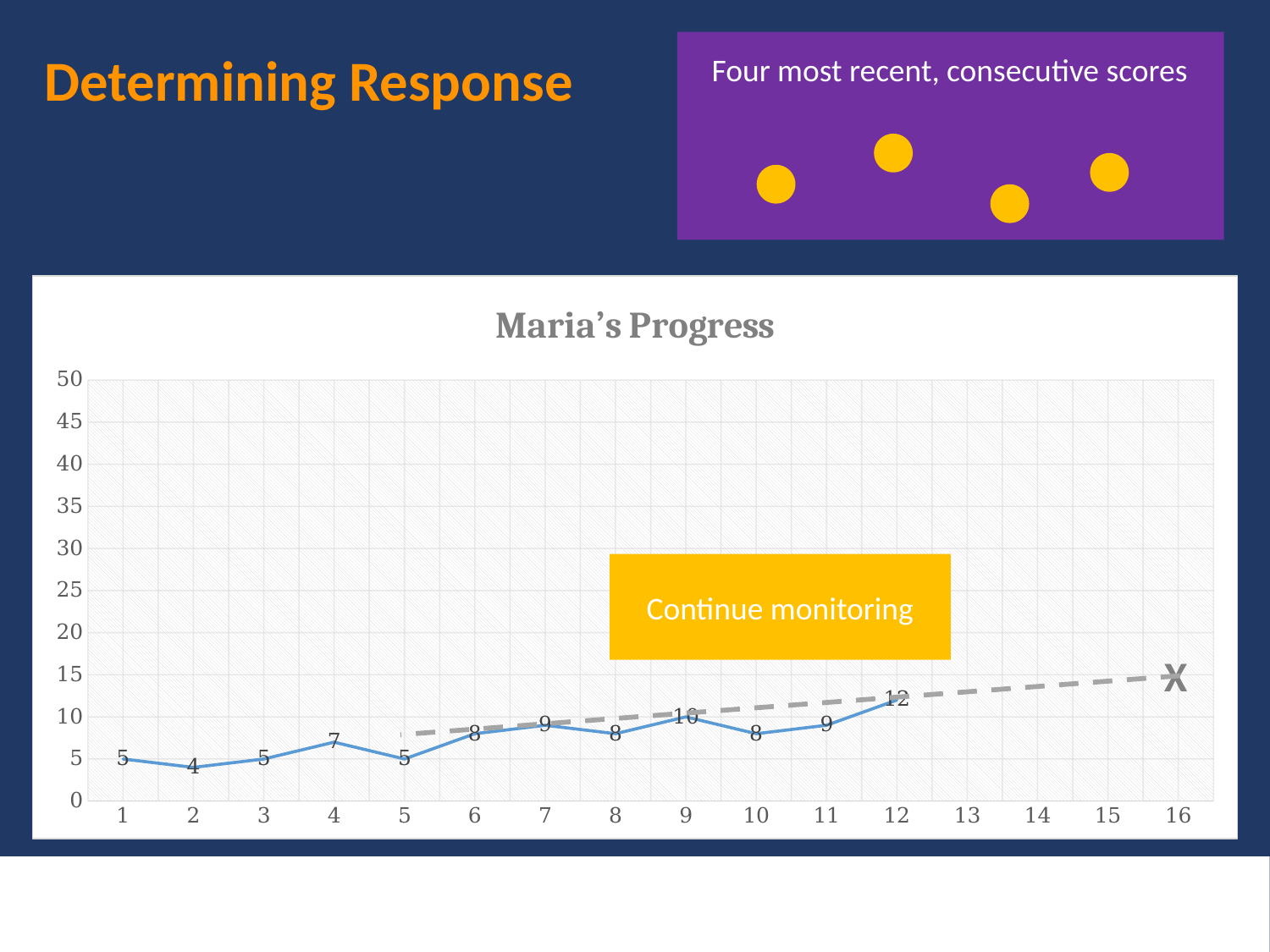
How many data points are plotted on the solid line? 12 What kind of chart is shown on the slide? line chart What is the value plotted at point 12? 12 Do the plotted values generally rise or fall from point 1 to point 12? rise At which x-axis point is the plotted value highest? 12 What is the value plotted at point 9? 10 What is the title of the chart? Maria's Progress At which x-axis point is the plotted value lowest? 2 What is the value plotted at point 2? 4 Is the value at point 12 greater or less than 10? greater What is the difference between the values at point 12 and point 1? 7 Which is larger, the value at point 4 or the value at point 5? point 4